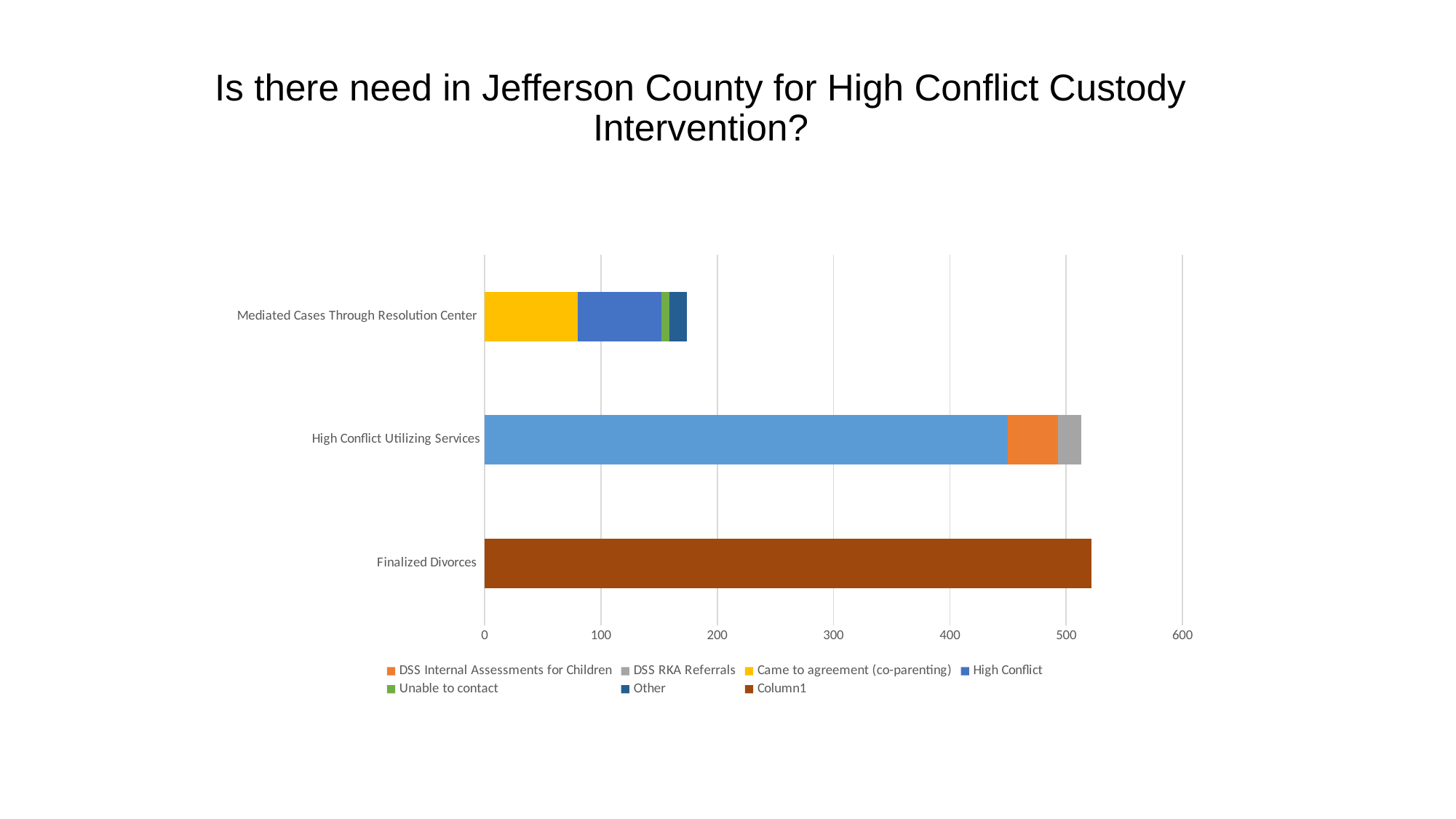
How many series does the chart's legend list? 7 Which category has the shortest total bar? Mediated Cases Through Resolution Center Is the total value for High Conflict Utilizing Services greater or less than 400? greater Which category has the longest total bar? Finalized Divorces Which has the larger total bar: High Conflict Utilizing Services or Mediated Cases Through Resolution Center? High Conflict Utilizing Services What kind of chart is shown on the slide? Stacked bar chart Is the total value for Finalized Divorces greater or less than 500? greater What is the title of the slide containing the chart? Is there need in Jefferson County for High Conflict Custody Intervention? Is the total value for Mediated Cases Through Resolution Center greater or less than 100? greater Which legend entry is shown in yellow? Came to agreement (co-parenting) How many categories are plotted on the vertical axis of the chart? 3